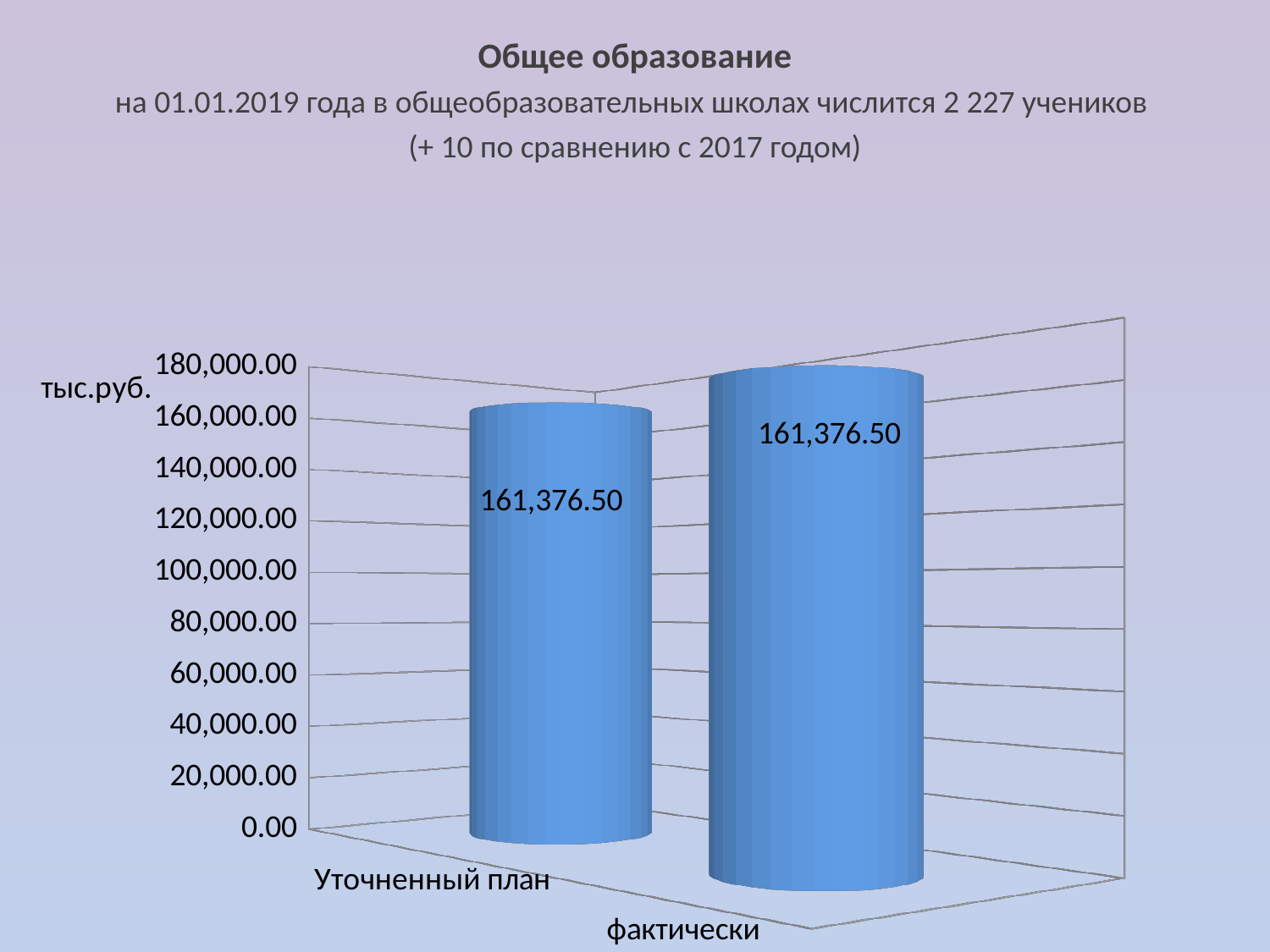
Is the value for Уточненный план greater or less than 140,000.00? greater What is the title of the slide containing the chart? Общее образование What unit is shown on the vertical axis of the chart? тыс.руб. What is the value for фактически? 161,376.50 Is the value for фактически greater or less than 180,000.00? less What is the value for Уточненный план? 161,376.50 What is the highest tick value shown on the vertical axis? 180,000.00 What kind of chart is shown on the slide? bar chart How many categories are plotted on the chart? 2 What is the difference between the values for Уточненный план and фактически? 0.00